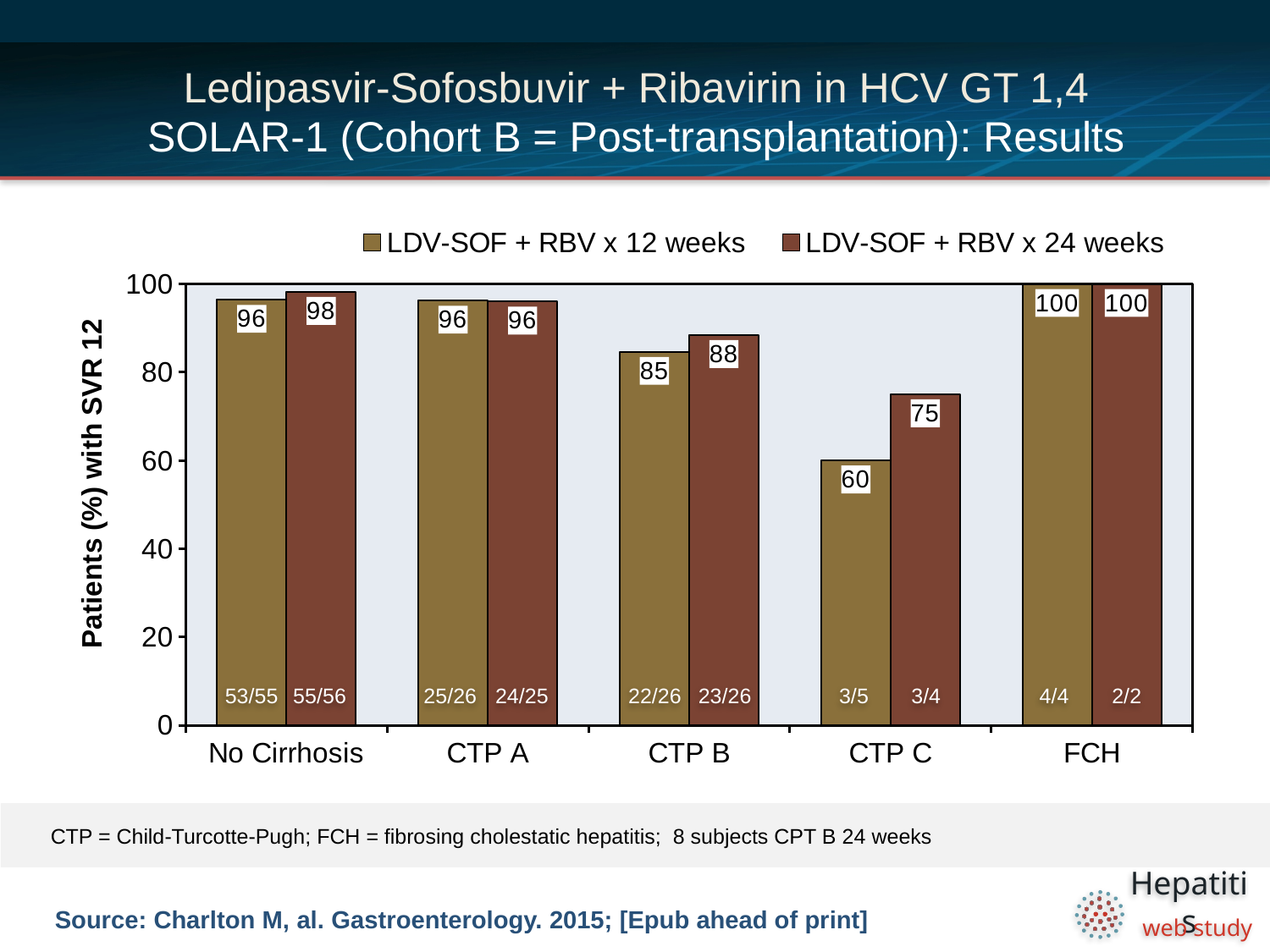
What is the difference between the 24-week and 12-week values for CTP C? 15 How many categories are shown on the x axis? 5 How many series does the legend list? 2 What is the difference between the 12-week values for CTP A and CTP B? 11 What kind of chart is shown on the slide? Bar chart What is the value for No Cirrhosis in the LDV-SOF + RBV x 24 weeks series? 98 Which is larger for CTP B: the 12-week value or the 24-week value? LDV-SOF + RBV x 24 weeks What is the value for CTP C in the LDV-SOF + RBV x 12 weeks series? 60 Which category has the lowest value in the LDV-SOF + RBV x 12 weeks series? CTP C What is the label of the y axis? Patients (%) with SVR 12 Which category has the highest value in the LDV-SOF + RBV x 24 weeks series? FCH What is the value for CTP B in the LDV-SOF + RBV x 24 weeks series? 88